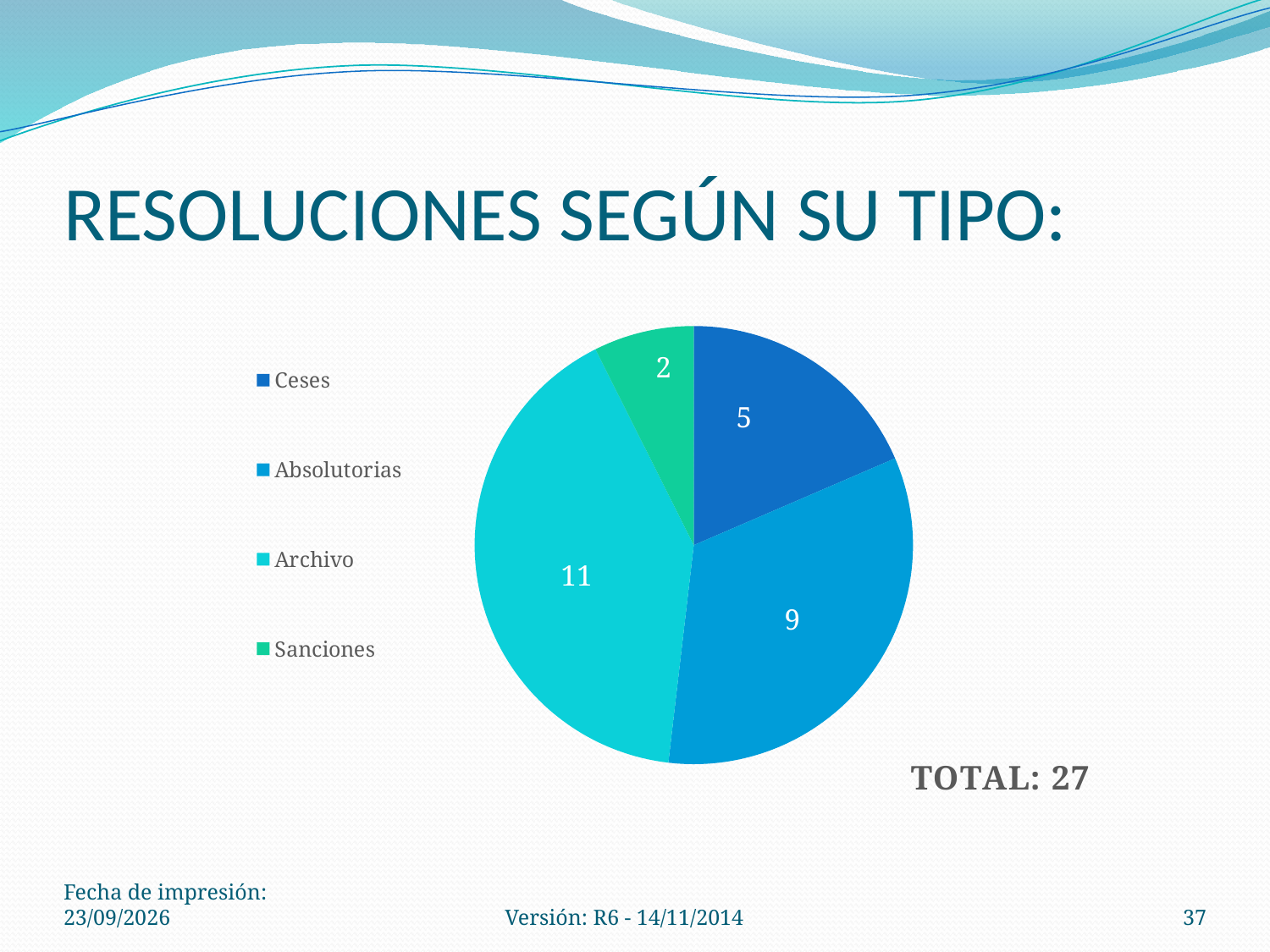
Which category has the largest slice? Archivo What is the difference between the values for Archivo and Absolutorias? 2 Which is larger, Absolutorias or Ceses? Absolutorias What is the difference between the values for Ceses and Sanciones? 3 How many categories does the pie chart have? 4 What is the total of all slices in the pie chart? 27 What type of chart is shown on the slide? pie chart Which category has the smallest slice? Sanciones What is the value for Archivo? 11 What is the value for Ceses? 5 What is the value for Absolutorias? 9 What is the value for Sanciones? 2